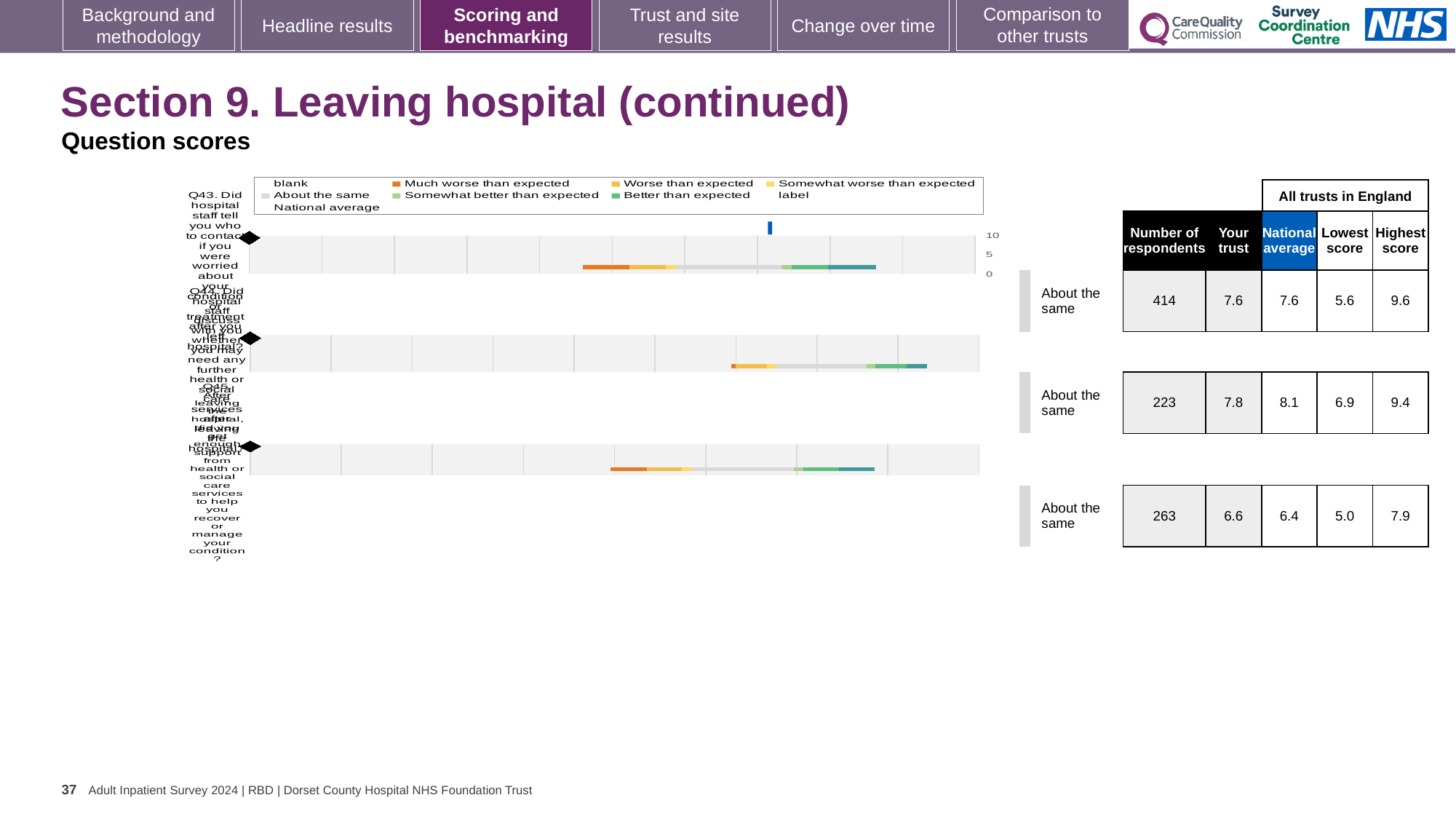
How many question charts (rows) are shown on the slide? 3 Which of the three charts has the lowest 'Your trust' score? the third chart (Q45), 6.6 For the third chart (Q45), how many respondents are there? 263 Is the 'Your trust' score for the first chart (Q43) greater or less than 5 on the axis? greater For the second chart (Q44), what is the difference between the national average and the 'Your trust' score? 0.3 For the first chart (Q43), what is the highest score among all trusts in England? 9.6 For the first chart (Q43), what is the 'Your trust' score? 7.6 Which of the three charts has the highest 'Your trust' score? the second chart (Q44), 7.8 For the third chart (Q45), which is larger: the 'Your trust' score or the national average? Your trust What kind of chart is used to show the question scores on this slide? bar chart For the second chart (Q44), what is the national average score? 8.1 What benchmark category label is shown beside each of the three charts? About the same